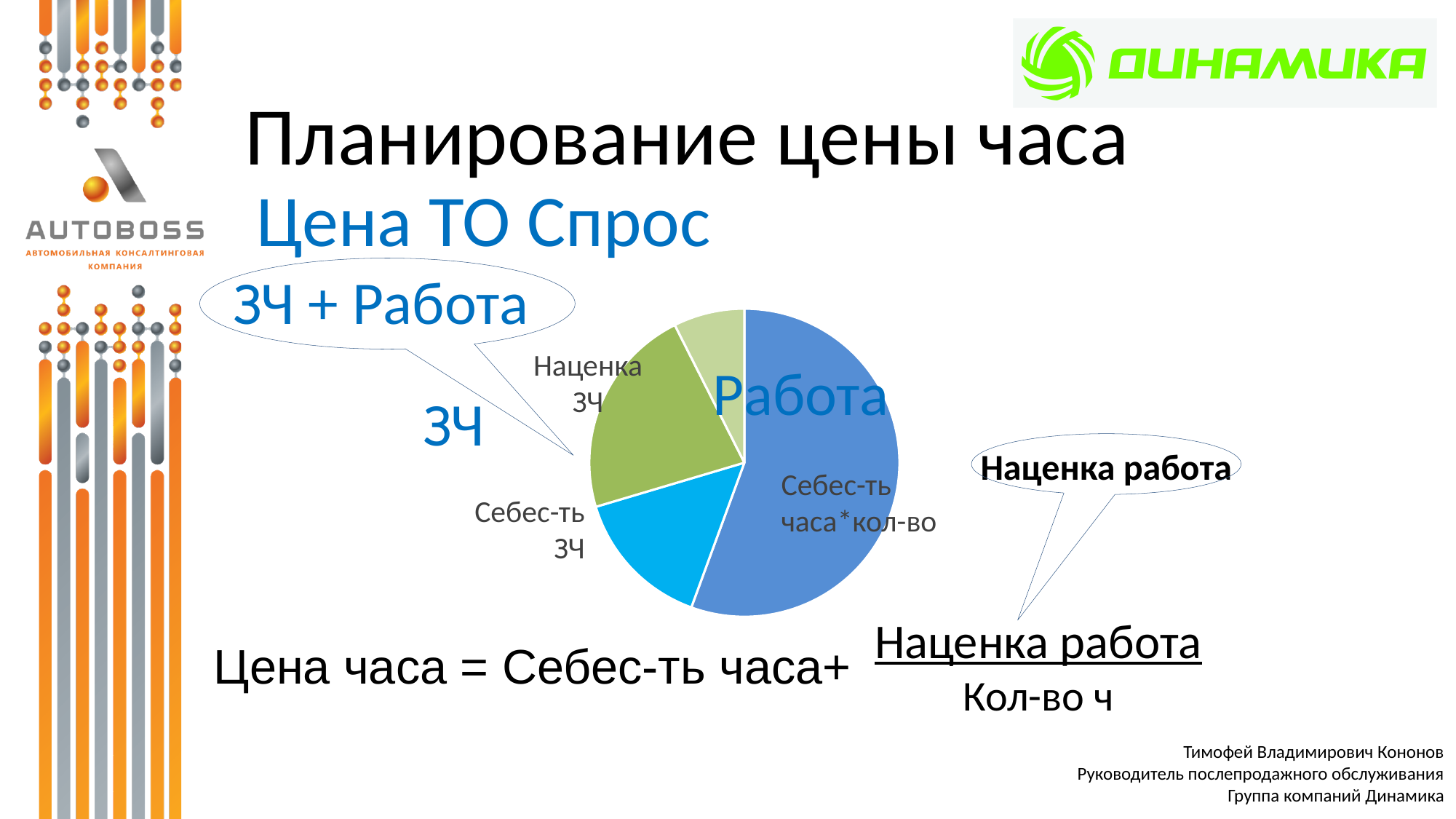
What kind of chart is shown on the slide? pie chart Does the Себес-ть часа*кол-во slice take up more or less than half of the pie chart? more Which slice is larger in the pie chart, Наценка ЗЧ or the light green slice? Наценка ЗЧ Which slice is larger in the pie chart, Себес-ть часа*кол-во or Себес-ть ЗЧ? Себес-ть часа*кол-во Which colour is the smallest slice of the pie chart? light green Which slice is larger in the pie chart, Себес-ть часа*кол-во or Наценка ЗЧ? Себес-ть часа*кол-во How many slices does the pie chart have? 4 What colour is the Наценка ЗЧ slice of the pie chart? green Which slice of the pie chart is the largest? Себес-ть часа*кол-во What colour is the Себес-ть ЗЧ slice of the pie chart? cyan